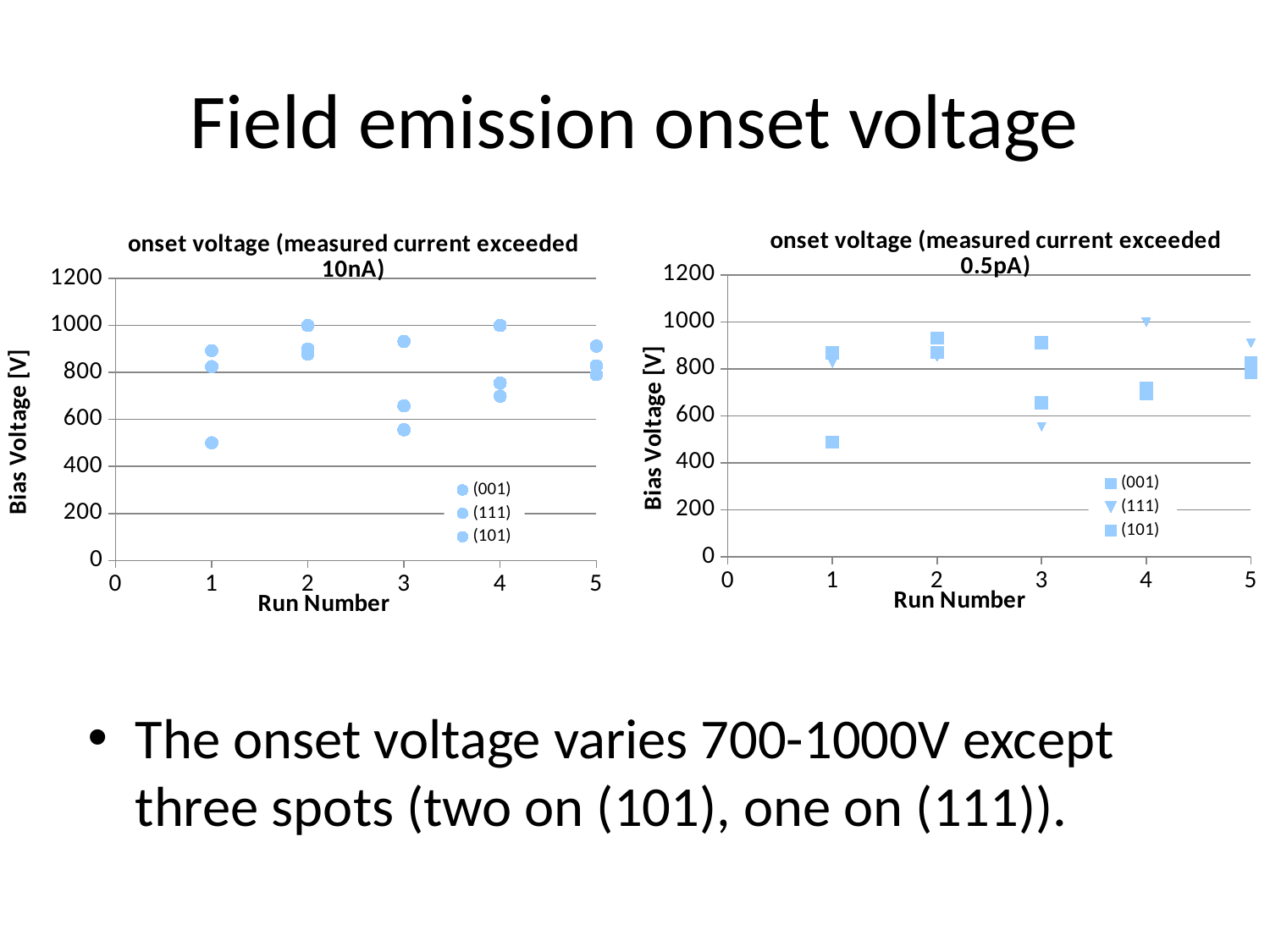
What kind of chart is the right chart titled "onset voltage (measured current exceeded 0.5pA)"? scatter chart How many run numbers are plotted along the x axis of the left chart (10nA)? 5 What kind of chart is the left chart titled "onset voltage (measured current exceeded 10nA)"? scatter chart In the right chart (0.5pA), is the value for series (111) at run number 1 greater or less than 600? greater In the right chart (0.5pA), is the value for series (111) at run number 4 larger or smaller than its value at run number 3? larger What is the y-axis label of the left chart (10nA)? Bias Voltage [V] How many series does the legend of the right chart (0.5pA) list? 3 How many series does the legend of the left chart (10nA) list? 3 What is the x-axis label of the right chart (0.5pA)? Run Number In the right chart (0.5pA), is the value for series (111) at run number 3 greater or less than 600? less In the right chart (0.5pA), is the value for series (111) at run number 5 greater or less than 800? greater